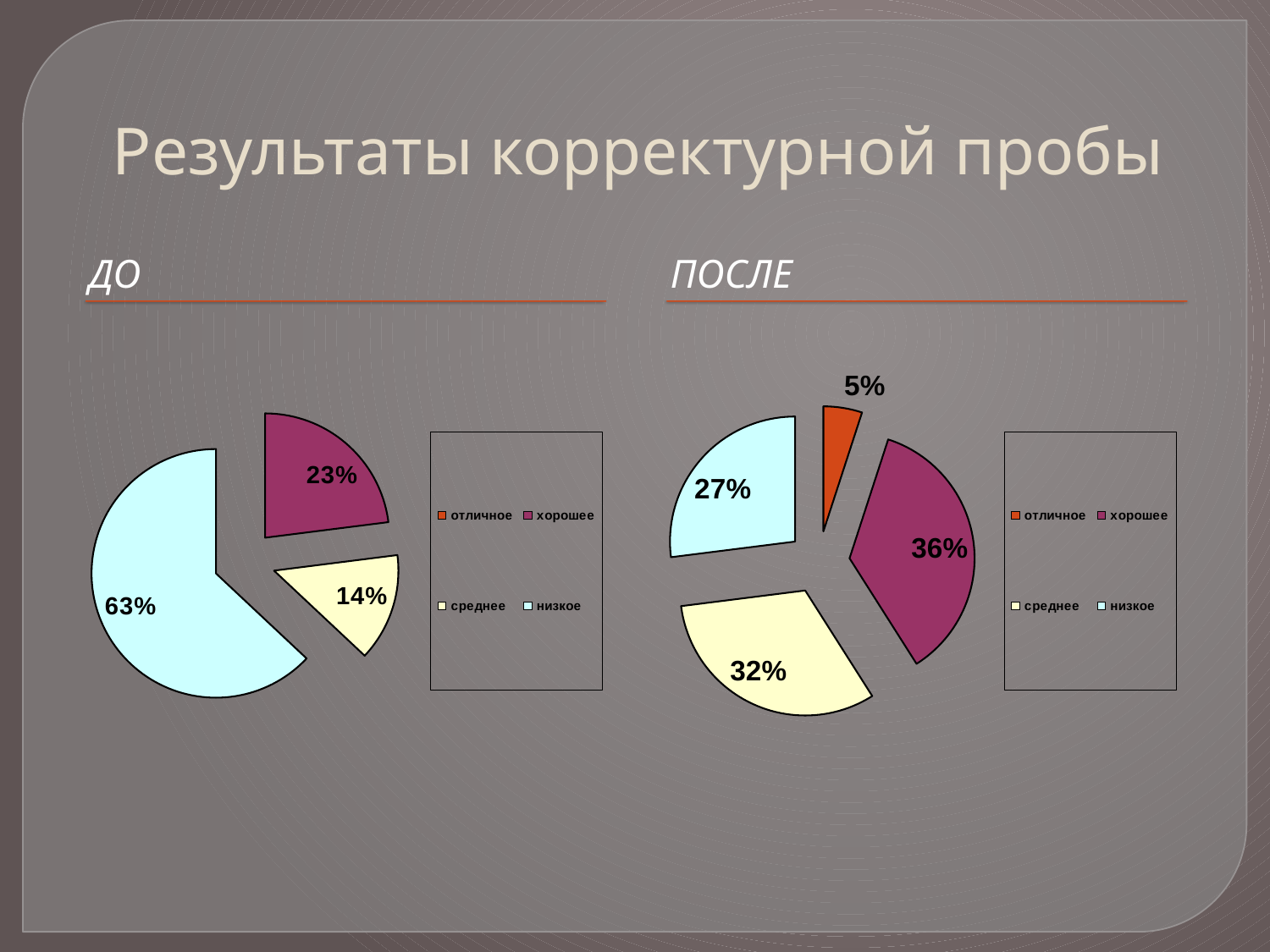
What type of chart is used on the slide? Pie chart In the "ДО" chart, which category has the smallest labelled slice? среднее How many slices are labelled in the "ПОСЛЕ" chart? 4 In the "ПОСЛЕ" chart, what share is labelled for the "среднее" slice? 32% In the "ПОСЛЕ" chart, what share is labelled for the "отличное" slice? 5% How many entries does the legend of the "ДО" chart list? 4 In the "ПОСЛЕ" chart, which category has the smallest slice? отличное What is the difference between the "низкое" share in the "ДО" chart and the "низкое" share in the "ПОСЛЕ" chart? 36% In the "ДО" chart, what share is labelled for the "низкое" slice? 63% In the "ПОСЛЕ" chart, which category has the largest slice? хорошее In the "ДО" chart, what share is labelled for the "хорошее" slice? 23% In the "ПОСЛЕ" chart, which is larger: the "хорошее" slice or the "низкое" slice? хорошее